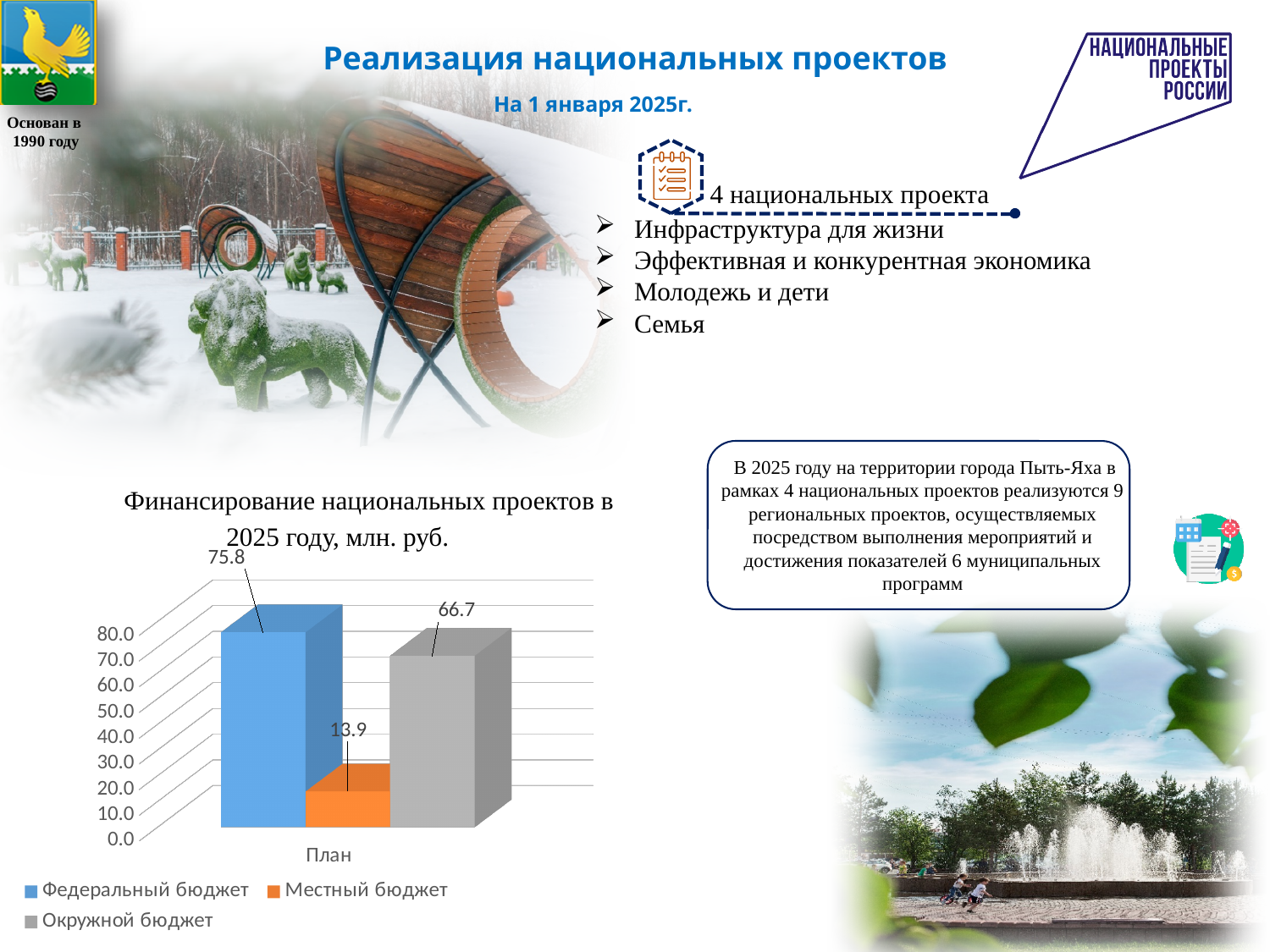
Is the value for Местный бюджет greater or less than 20.0? less What is the value for Окружной бюджет in the chart? 66.7 Which is larger, the value for Федеральный бюджет or the value for Окружной бюджет? Федеральный бюджет What is the value for Федеральный бюджет in the chart? 75.8 How many series does the legend list? 3 What is the difference between the values for Федеральный бюджет and Окружной бюджет? 9.1 What is the difference between the values for Окружной бюджет and Местный бюджет? 52.8 What is the title of the chart? Финансирование национальных проектов в 2025 году, млн. руб. Which series has the highest value in the chart? Федеральный бюджет Which series has the lowest value in the chart? Местный бюджет What is the value for Местный бюджет in the chart? 13.9 What kind of chart is shown on the slide? bar chart